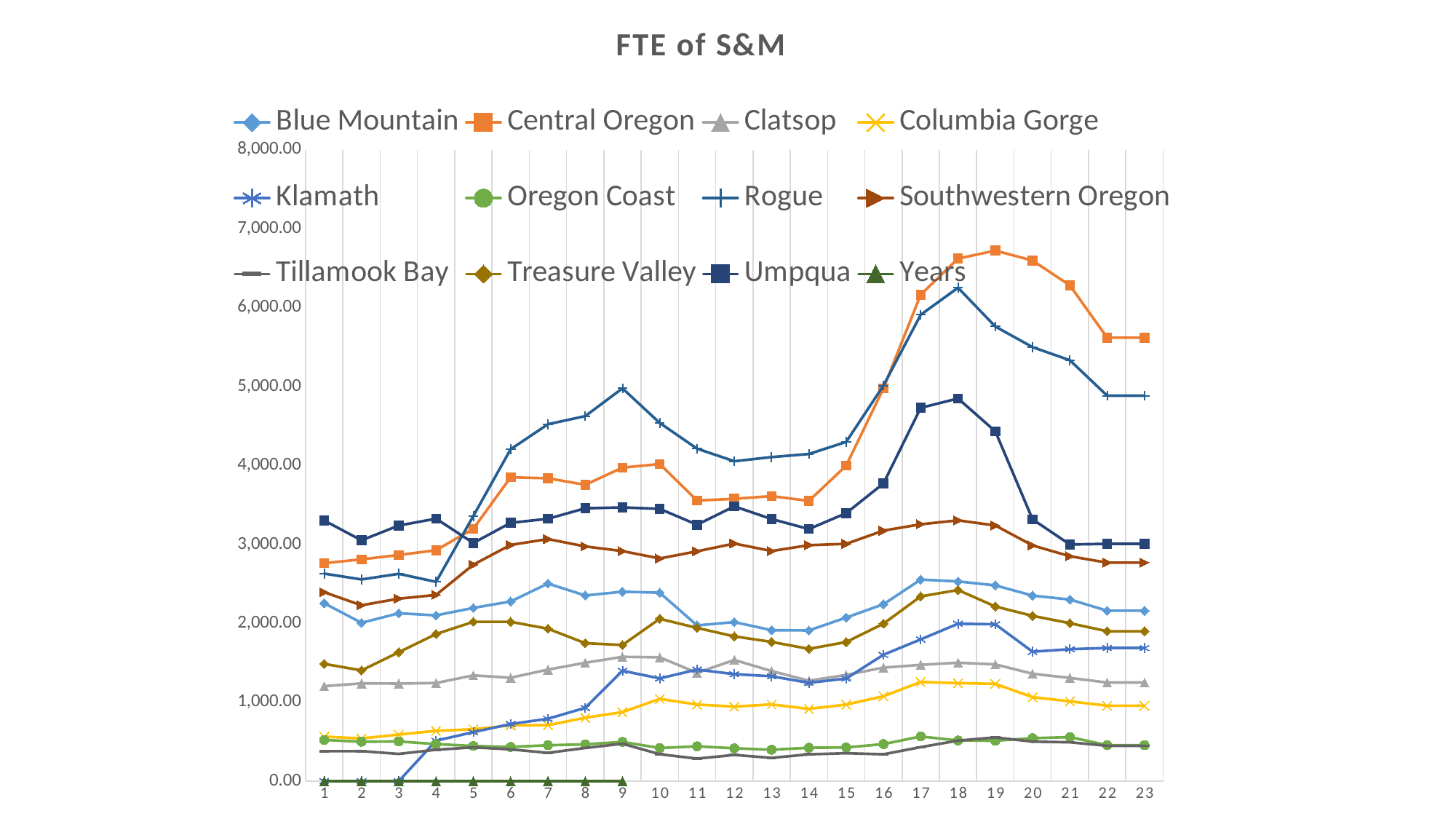
What kind of chart is shown on the slide? line chart What is the title of the chart? FTE of S&M At point 23, which is larger: Rogue or Umpqua? Rogue Does the Central Oregon line rise or fall from point 19 to point 22? fall How many series does the legend list? 12 Is the value for Klamath at point 20 greater or less than 2,000.00? less Which series has the highest value at point 19? Central Oregon At point 1, which is larger: Umpqua or Central Oregon? Umpqua Is the value for Central Oregon at point 19 greater or less than 6,000.00? greater How many points are there along the x axis? 23 Is the value for Rogue at point 18 greater or less than 6,000.00? greater